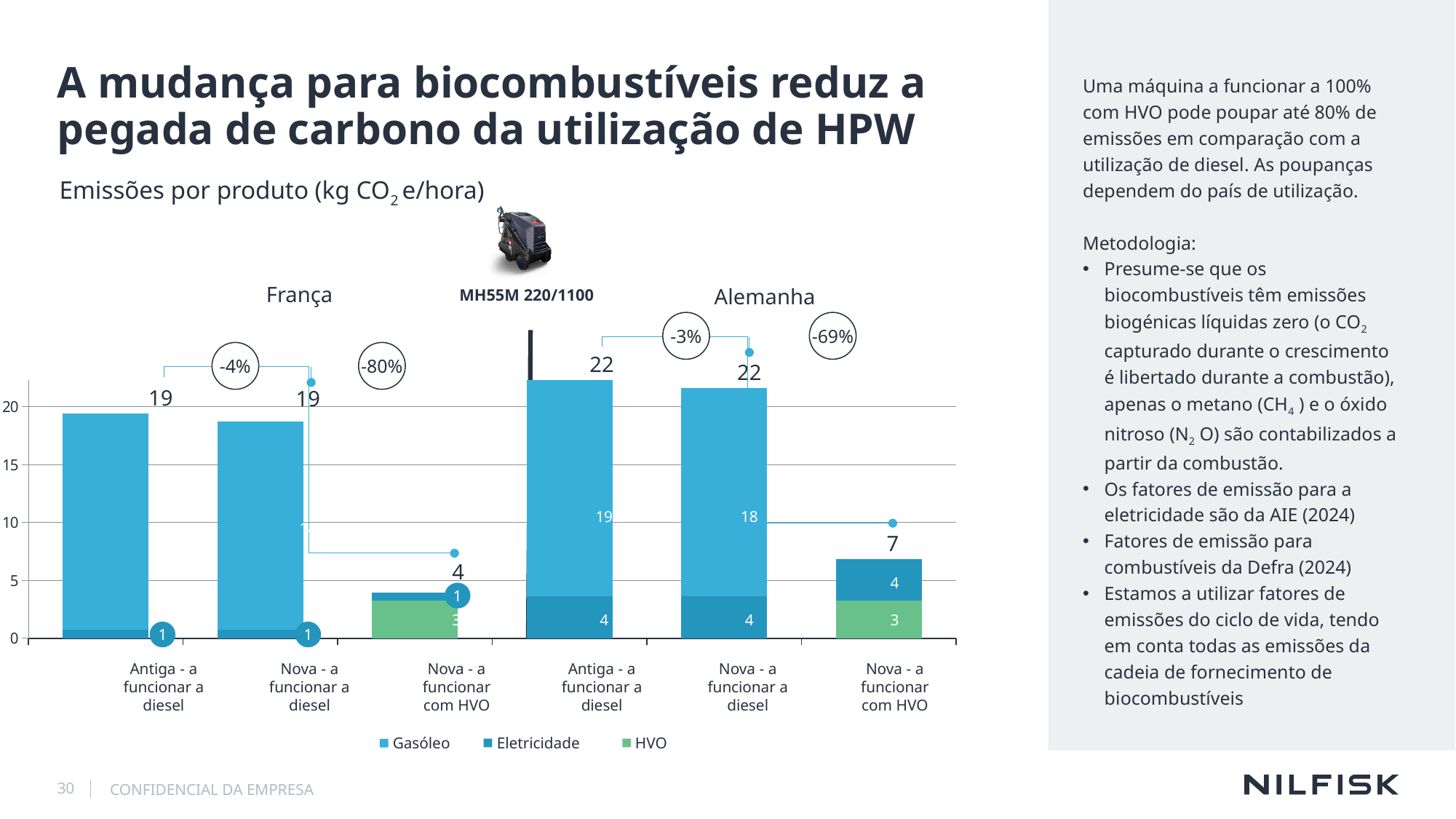
What percentage reduction is annotated between the new diesel machine and the new HVO machine under França? -80% What kind of chart is shown on the slide? Stacked bar chart What is the Eletricidade value for the 'Antiga - a funcionar a diesel' bar under Alemanha? 4 How many bars are plotted in the chart? 6 Which has the higher total emissions: 'Nova - a funcionar com HVO' under França or under Alemanha? Alemanha What is the HVO value for the 'Nova - a funcionar com HVO' bar under Alemanha? 3 Which bar has the lowest total emissions? Nova - a funcionar com HVO (França) What is the Gasóleo value for the 'Nova - a funcionar a diesel' bar under Alemanha? 18 What is the total emissions value for the 'Antiga - a funcionar a diesel' bar under Alemanha? 22 What is the total emissions value for the 'Nova - a funcionar com HVO' bar under França? 4 What is the difference between the total for 'Antiga - a funcionar a diesel' and 'Nova - a funcionar com HVO' under Alemanha? 15 How many series does the chart legend list? 3